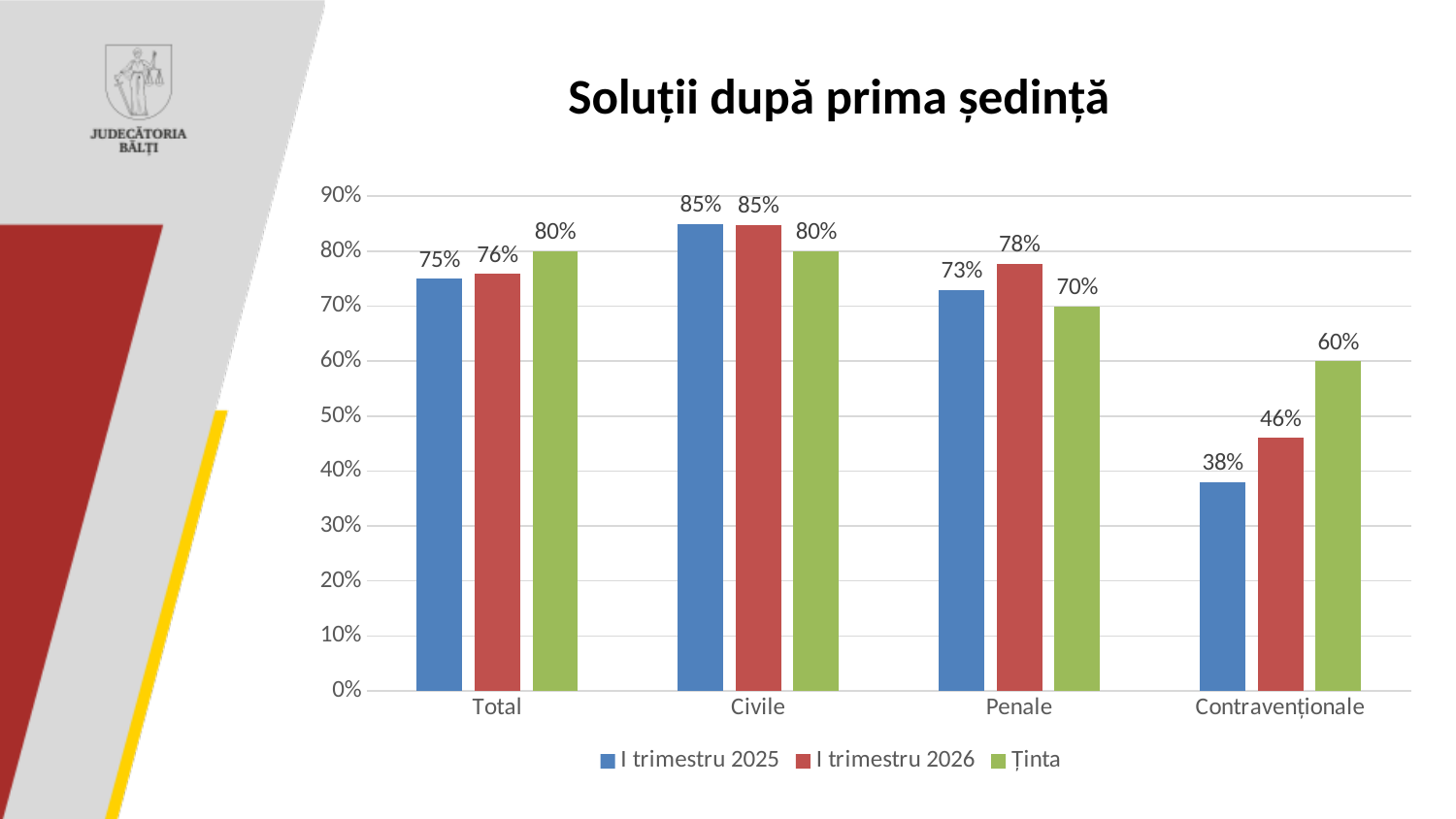
What is the Ținta value for Contravenționale? 60% What is the value for Penale in the I trimestru 2026 series? 78% How many categories are shown on the x axis? 4 Which category has the lowest value in the I trimestru 2025 series? Contravenționale What kind of chart is shown on the slide? bar chart Which category has the highest value in the I trimestru 2026 series? Civile How many series does the legend list? 3 Which is larger for Penale: the I trimestru 2026 value or the Ținta value? I trimestru 2026 What is the title of the chart? Soluții după prima ședință What is the value for Civile in the I trimestru 2025 series? 85% What is the difference between the I trimestru 2026 value and the I trimestru 2025 value for Contravenționale? 8% Is the I trimestru 2025 value for Contravenționale greater or less than 40%? less